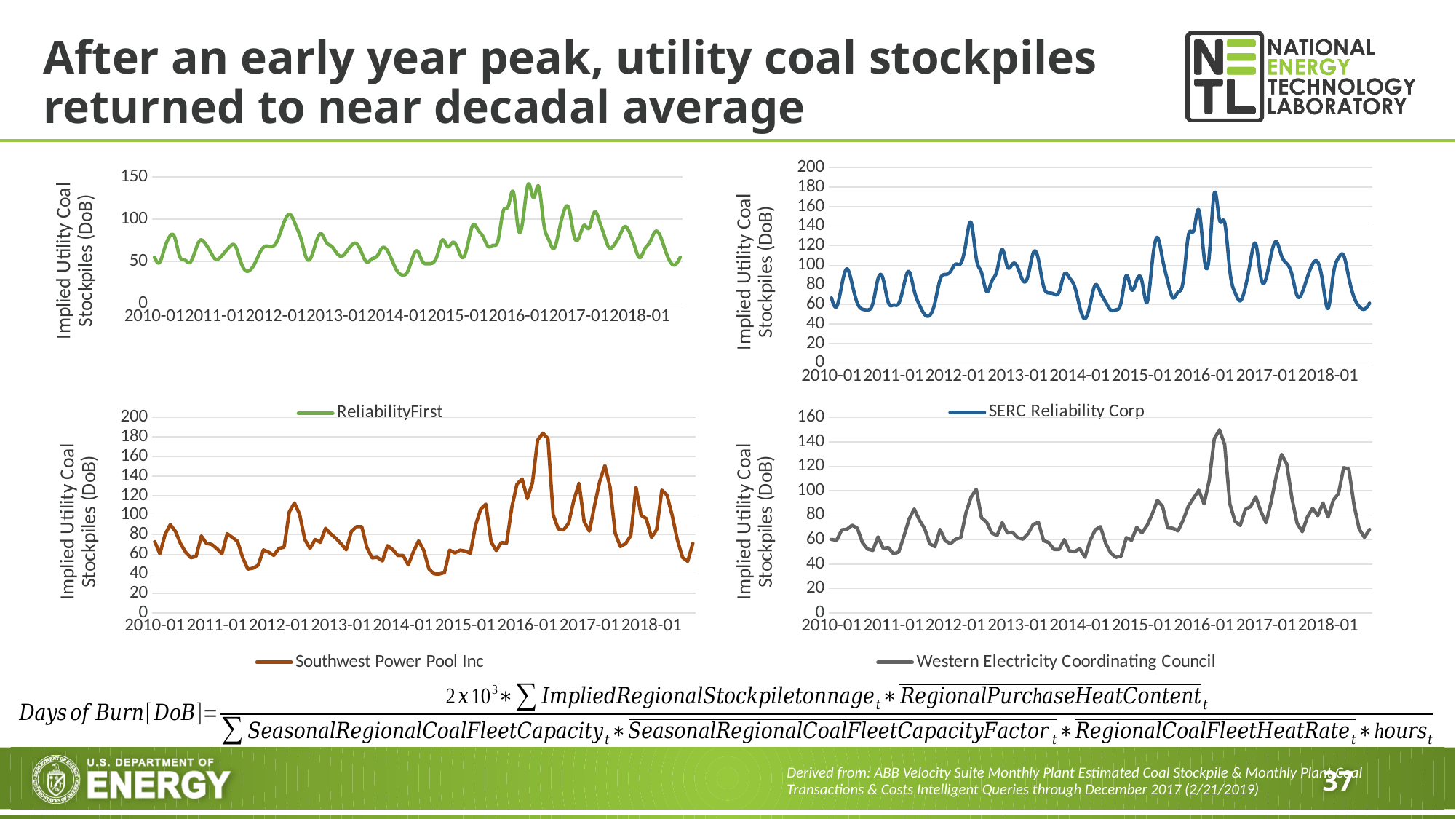
In the ReliabilityFirst chart, is the highest value of the series greater or less than 100? greater How many charts are shown on the slide? 4 In the SERC Reliability Corp chart, is the highest value of the series greater or less than 160? greater In the Western Electricity Coordinating Council chart, is the lowest value of the series greater or less than 60? less What kind of chart is the ReliabilityFirst chart? line chart How many series does the legend of the Southwest Power Pool Inc chart list? 1 What is the legend entry of the top-right chart? SERC Reliability Corp What is the y-axis label of the Western Electricity Coordinating Council chart? Implied Utility Coal Stockpiles (DoB)